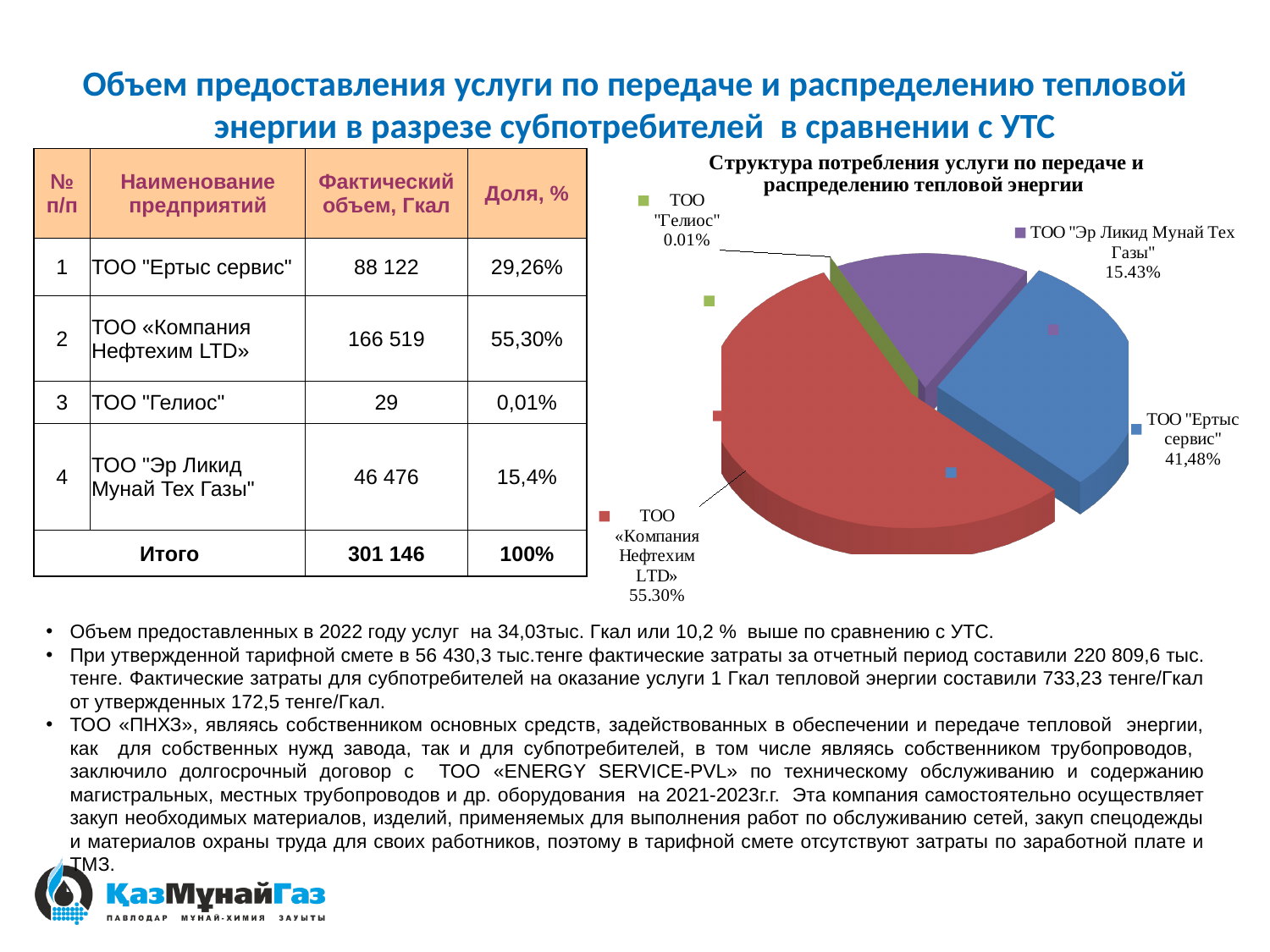
What share does the pie chart show for ТОО «Компания Нефтехим LTD»? 55.30% Which company has the largest slice in the pie chart? ТОО «Компания Нефтехим LTD» Which company has the smallest slice in the pie chart? ТОО "Гелиос" In the pie chart, which slice is larger: ТОО "Ертыс сервис" or ТОО "Эр Ликид Мунай Тех Газы"? ТОО "Ертыс сервис" What share does the pie chart show for ТОО "Гелиос"? 0.01% In the pie chart, what is the difference between the shares of ТОО «Компания Нефтехим LTD» and ТОО "Эр Ликид Мунай Тех Газы"? 39.87% What share does the pie chart show for ТОО "Эр Ликид Мунай Тех Газы"? 15.43% What colour is the slice for ТОО «Компания Нефтехим LTD» in the pie chart? red What is the title of the pie chart? Структура потребления услуги по передаче и распределению тепловой энергии How many slices does the pie chart have? 4 What kind of chart is shown on the slide? pie chart